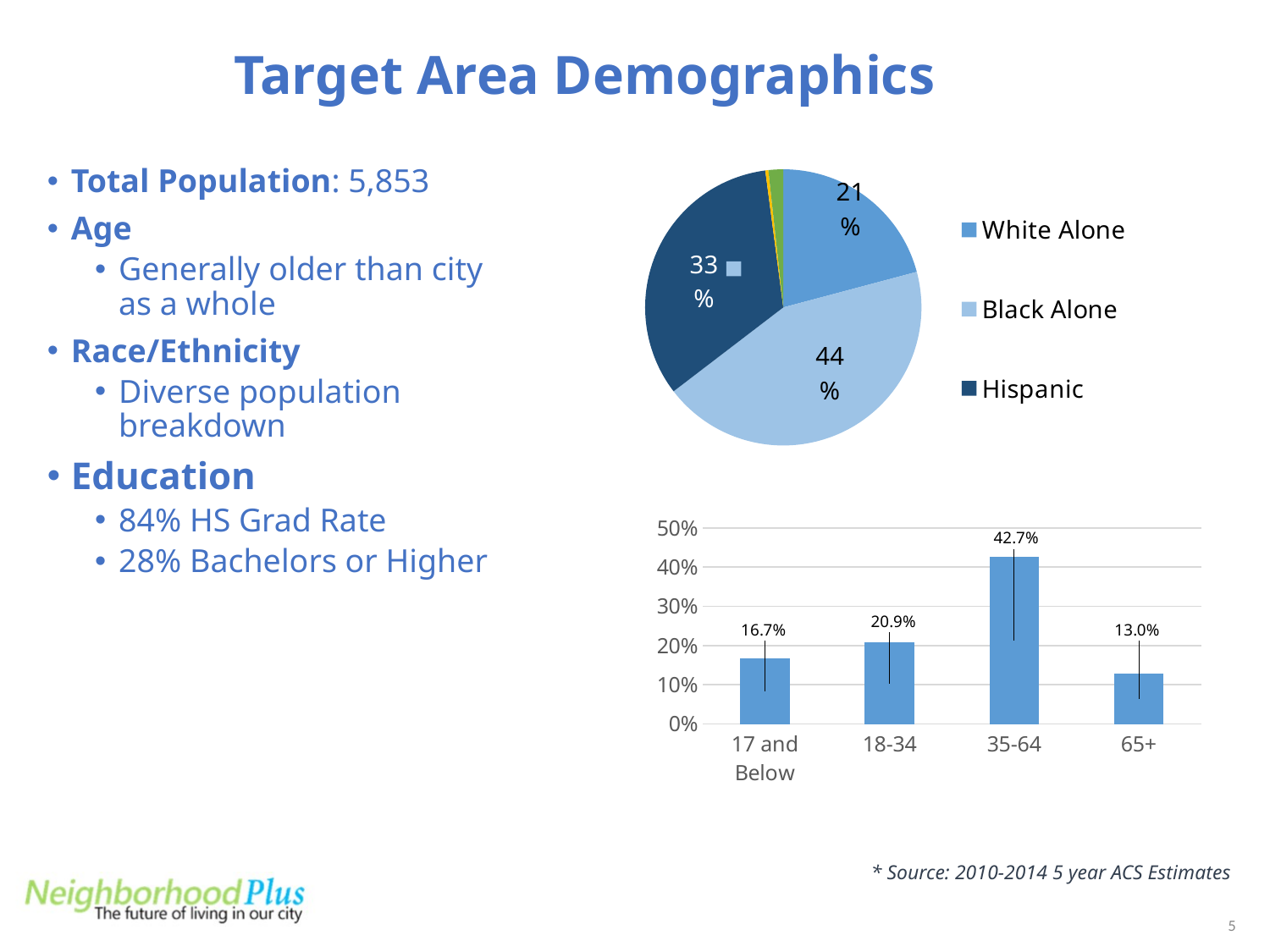
In the bar chart at the bottom right, what is the difference between the values for 35-64 and 18-34? 21.8% In the pie chart at the top right, what share of the pie is labelled for Hispanic? 33% In the bar chart at the bottom right, what is the value for the 35-64 age group? 42.7% In the pie chart at the top right, which labelled slice is the largest? Black Alone In the bar chart at the bottom right, which age group has the lowest value? 65+ What kind of chart is the chart at the bottom right of the slide? bar chart In the bar chart at the bottom right, which is larger, the value for 18-34 or the value for 65+? 18-34 In the bar chart at the bottom right, how many age groups are shown on the x axis? 4 In the bar chart at the bottom right, which age group has the highest value? 35-64 How many entries does the legend of the pie chart at the top right list? 3 In the pie chart at the top right, what share of the pie is labelled for Black Alone? 44% In the bar chart at the bottom right, what is the value for the 17 and Below age group? 16.7%